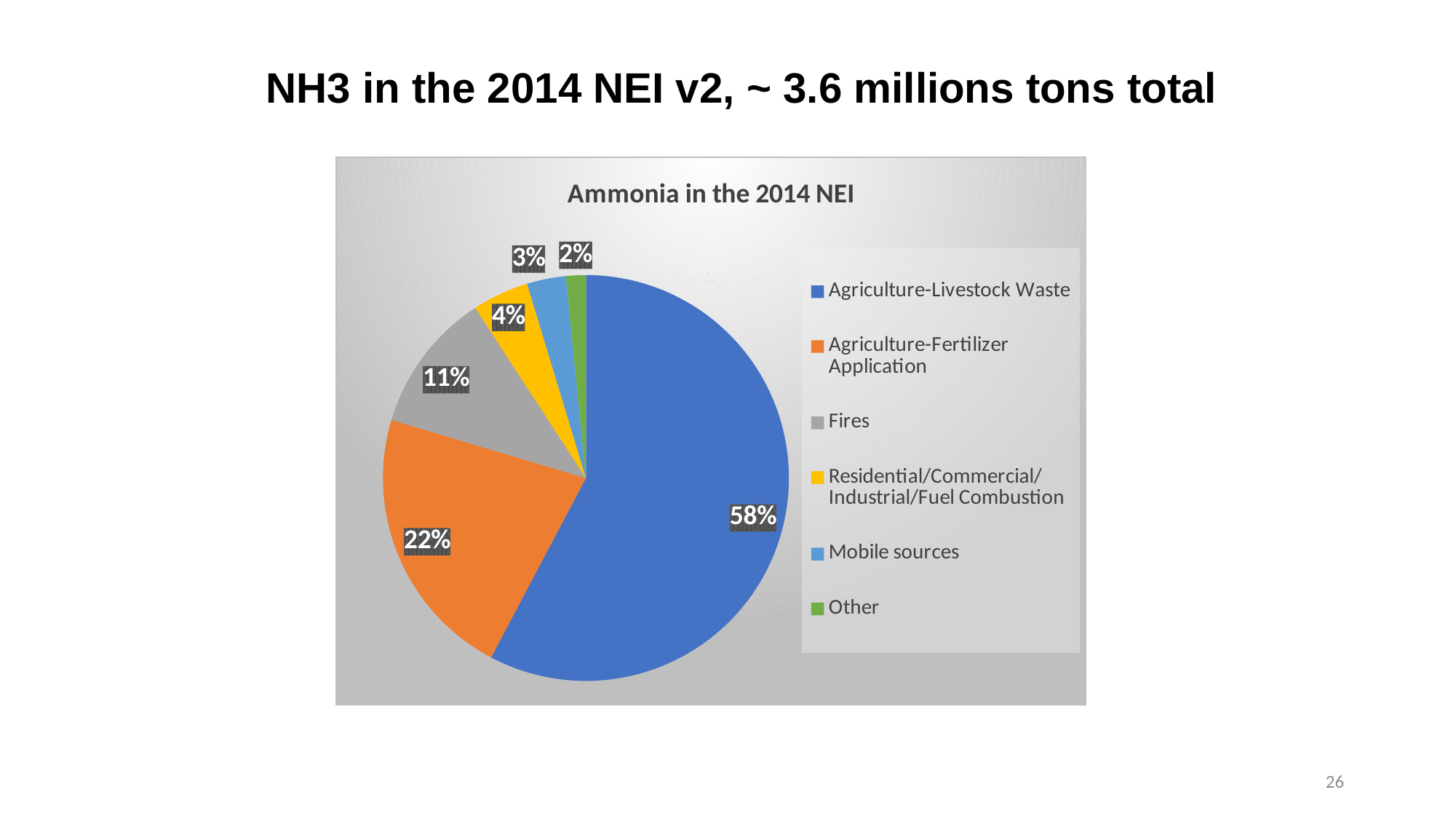
What share of the pie does Residential/Commercial/Industrial/Fuel Combustion account for? 4% What is the difference in percentage points between Agriculture-Livestock Waste and Agriculture-Fertilizer Application? 36 What type of chart is shown on the slide? pie chart What share of the pie does Agriculture-Livestock Waste account for? 58% What share of the pie does Other account for? 2% What is the title of the chart? Ammonia in the 2014 NEI Which category has the smallest slice of the pie? Other Which category has the largest slice of the pie? Agriculture-Livestock Waste How many categories does the legend list? 6